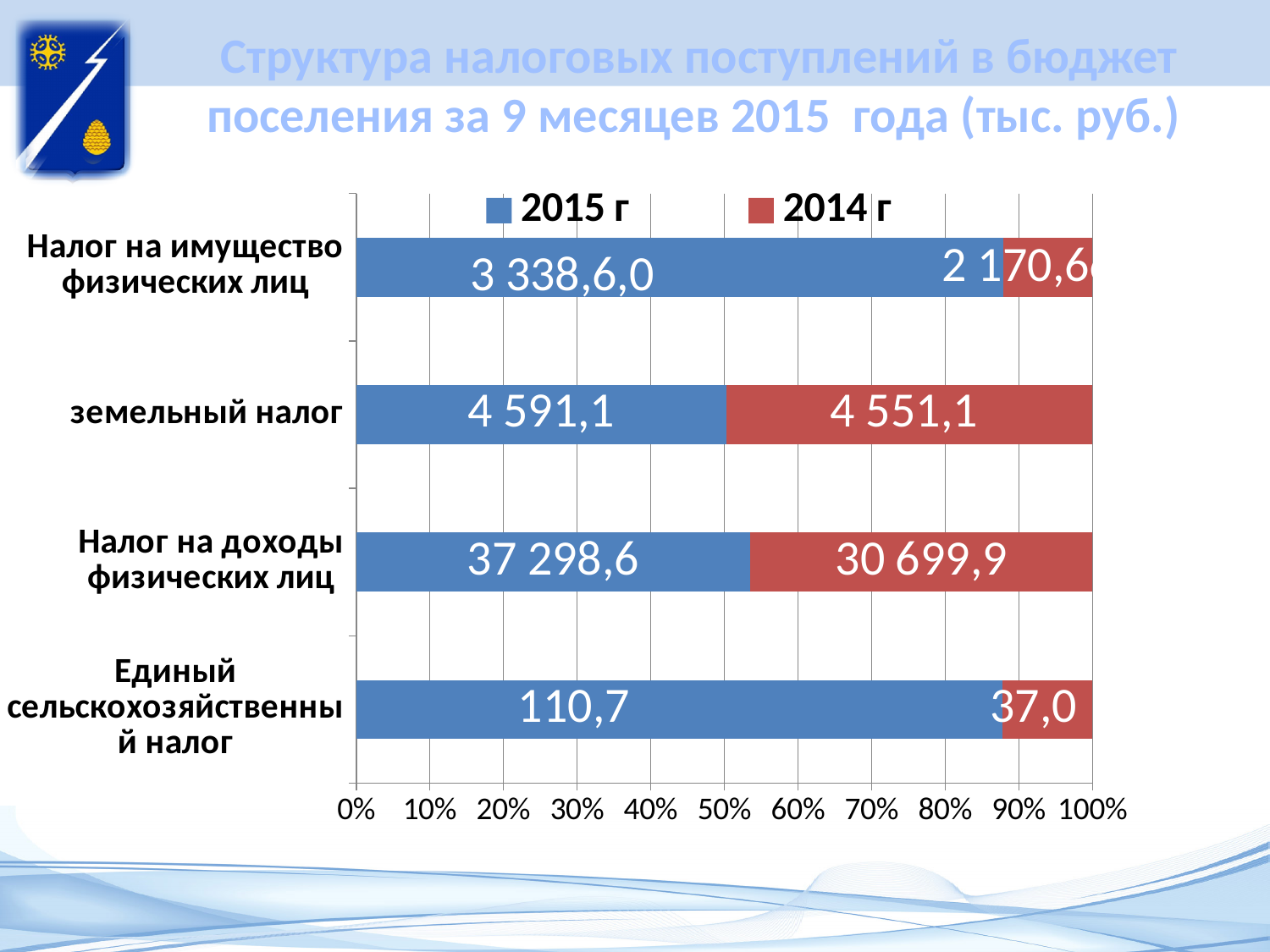
For земельный налог, which year has the larger value, 2015 г or 2014 г? 2015 г How many series does the legend list? 2 Which category has the highest 2015 г value? Налог на доходы физических лиц What is the 2014 г value for Единый сельскохозяйственный налог? 37,0 What is the 2015 г value for Налог на доходы физических лиц? 37 298,6 What kind of chart is shown on the slide? bar chart What is the difference between the 2015 г and 2014 г values for Единый сельскохозяйственный налог? 73,7 What is the difference between the 2015 г and 2014 г values for Налог на доходы физических лиц? 6 598,7 What is the 2014 г value for земельный налог? 4 551,1 Is the 2015 г share of the bar for Единый сельскохозяйственный налог greater or less than 80%? greater What is the 2015 г value for земельный налог? 4 591,1 How many tax categories are shown on the chart? 4